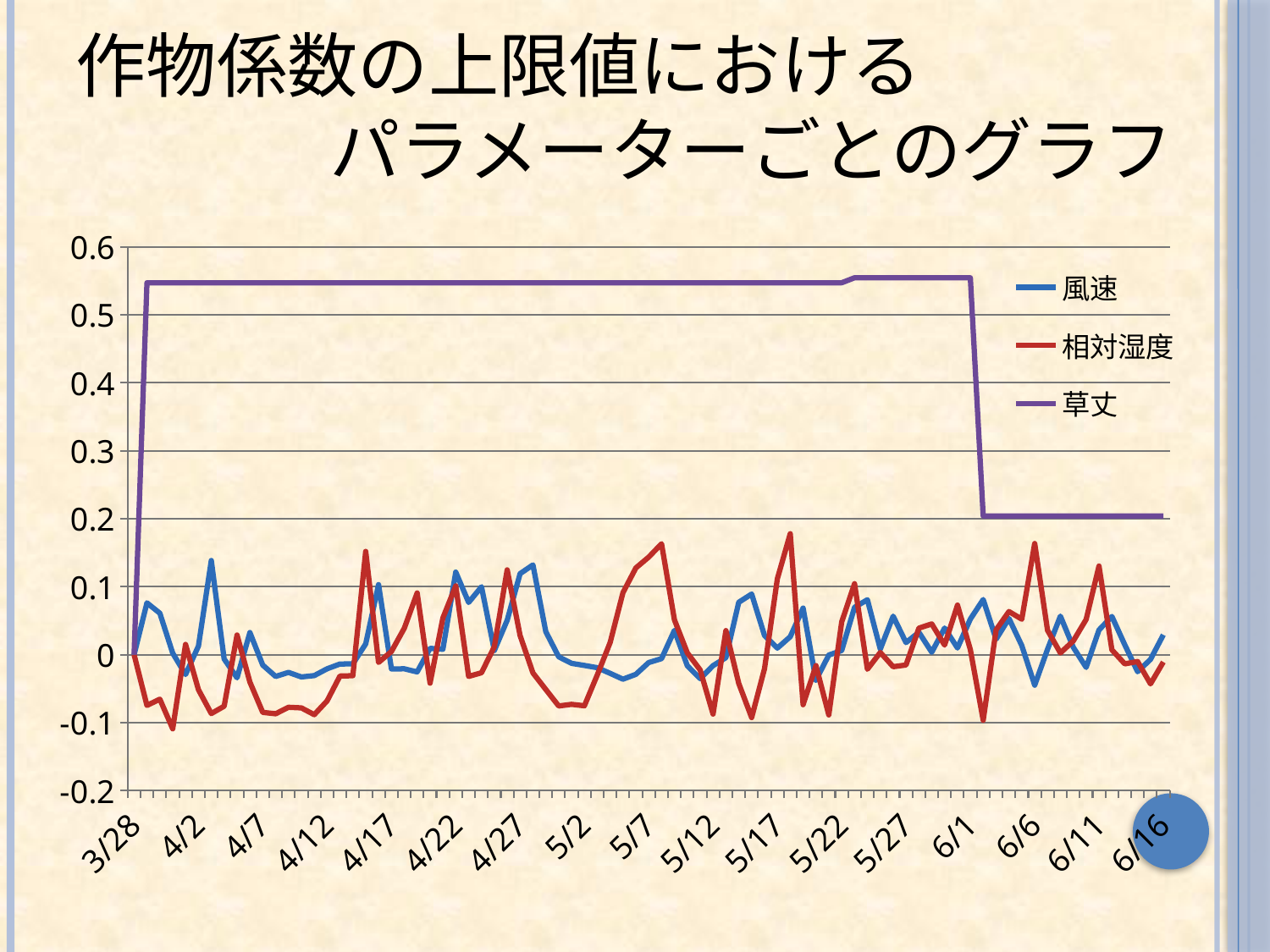
What is the highest value shown on the y axis? 0.6 How many date labels are shown on the x axis? 17 Is the value of 草丈 on 6/11 greater or less than 0.3? less Is the value of 風速 on 4/12 greater or less than 0.1? less Which series has the highest value on 5/2? 草丈 Is the value of 草丈 on 4/12 greater or less than 0.5? greater How many series does the legend list? 3 Does the 草丈 line rise or fall between 6/1 and 6/6? fall What kind of chart is shown on the slide? line chart What colour is the 相対湿度 line? red Does the 草丈 line rise or fall between 3/28 and 4/2? rise What are the three series named in the legend? 風速, 相対湿度, 草丈